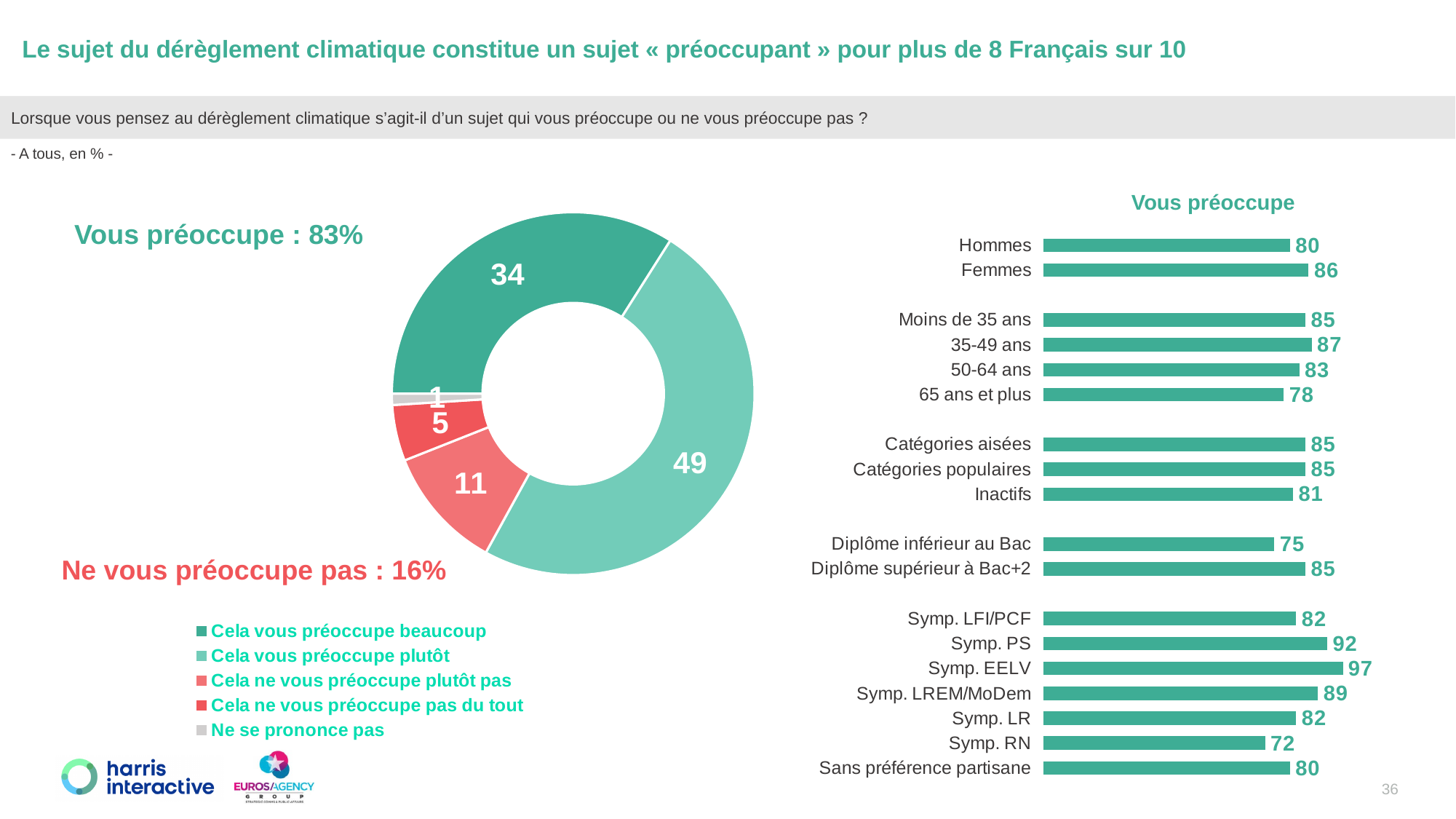
What kind of chart is the "Vous préoccupe" chart on the right? Bar chart In the donut chart on the left, what value is shown for "Cela ne vous préoccupe plutôt pas"? 11 In the "Vous préoccupe" bar chart on the right, what is the difference between the values for Diplôme supérieur à Bac+2 and Diplôme inférieur au Bac? 10 In the donut chart on the left, which category has the smallest slice? Ne se prononce pas In the donut chart on the left, which category has the largest slice? Cela vous préoccupe plutôt In the "Vous préoccupe" bar chart on the right, which is larger, the value for Hommes or the value for Femmes? Femmes In the donut chart on the left, what value is shown for "Cela vous préoccupe plutôt"? 49 In the donut chart on the left, how many categories does the legend list? 5 In the "Vous préoccupe" bar chart on the right, what is the value for Symp. EELV? 97 In the "Vous préoccupe" bar chart on the right, what is the value for 65 ans et plus? 78 In the "Vous préoccupe" bar chart on the right, which category has the lowest value? Symp. RN In the donut chart on the left, what is the difference between the values for "Cela vous préoccupe plutôt" and "Cela vous préoccupe beaucoup"? 15